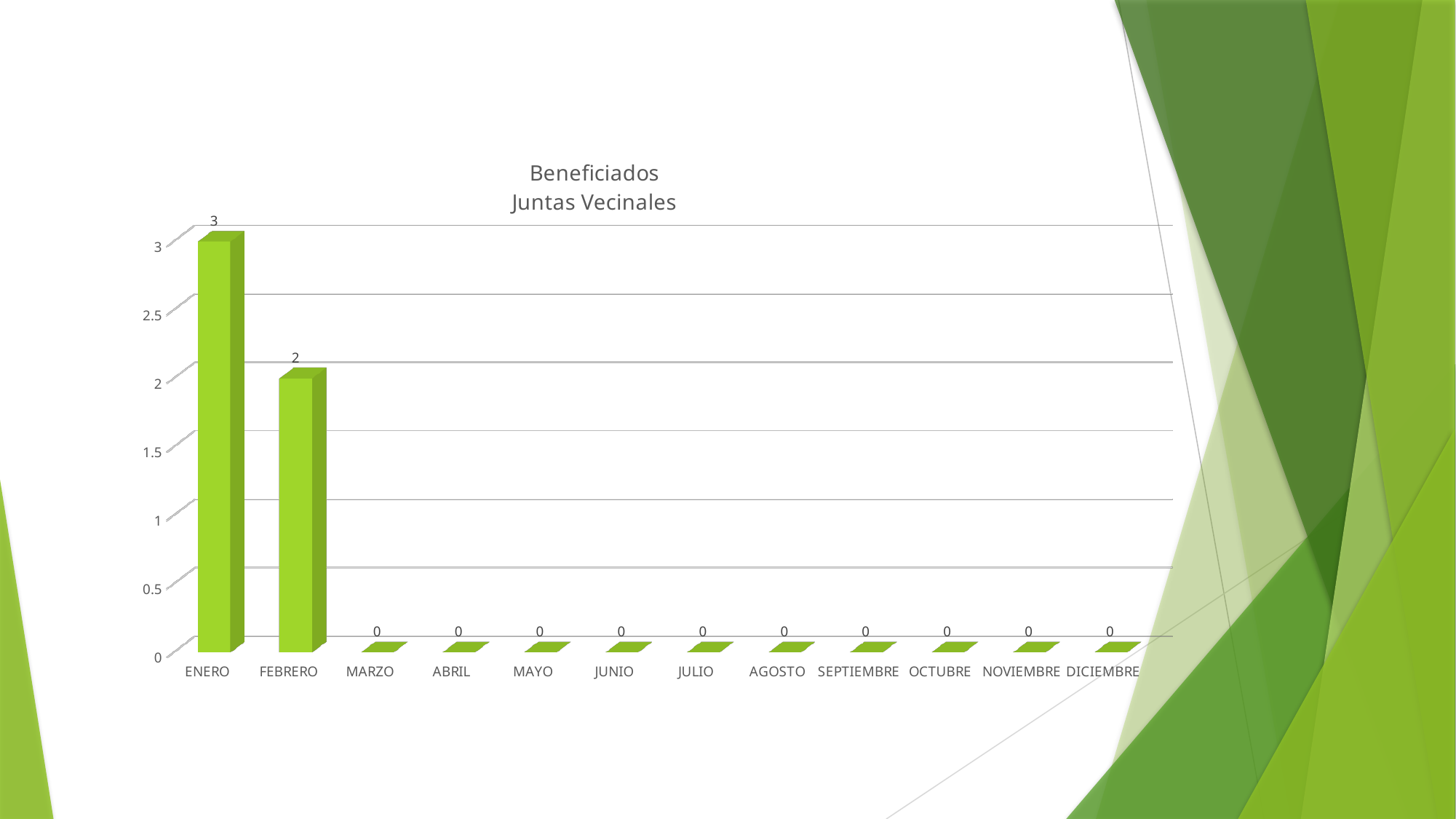
How many months have a value of 0? 10 What is the value for ENERO? 3 What is the value for MARZO? 0 What is the title of the chart? Beneficiados Juntas Vecinales Which is larger, the value for ENERO or the value for FEBRERO? ENERO What is the value for FEBRERO? 2 What is the value for DICIEMBRE? 0 What is the difference between the values for ENERO and FEBRERO? 1 What kind of chart is shown? bar chart Which month has the highest value? ENERO How many categories are shown on the x axis? 12 Do the values rise or fall from ENERO to FEBRERO? fall